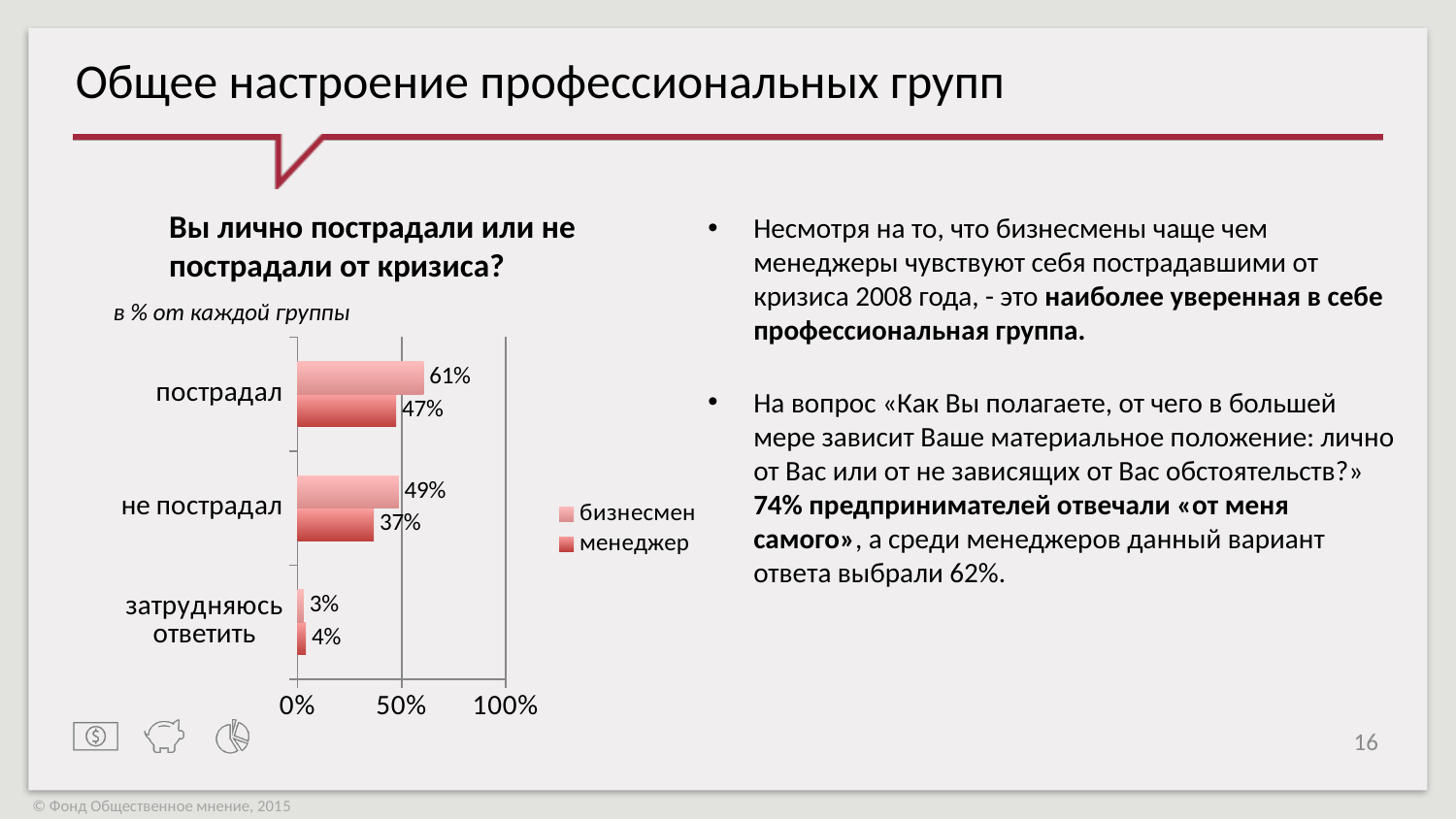
How many answer categories are shown on the chart? 3 What percentage of managers (менеджер) answered "затрудняюсь ответить"? 4% What is the title of the chart? Вы лично пострадали или не пострадали от кризиса? What percentage of businessmen (бизнесмен) answered "пострадал"? 61% What percentage of managers (менеджер) answered "не пострадал"? 37% What is the difference between businessmen and managers for "пострадал"? 14 percentage points Which category has the lowest value for managers (менеджер)? затрудняюсь ответить For "не пострадал", which group has the larger value: бизнесмен or менеджер? бизнесмен Which category has the highest value for businessmen (бизнесмен)? пострадал Is the value for managers (менеджер) answering "пострадал" greater or less than 50%? less What type of chart is shown on the slide? bar chart How many series does the legend list? 2